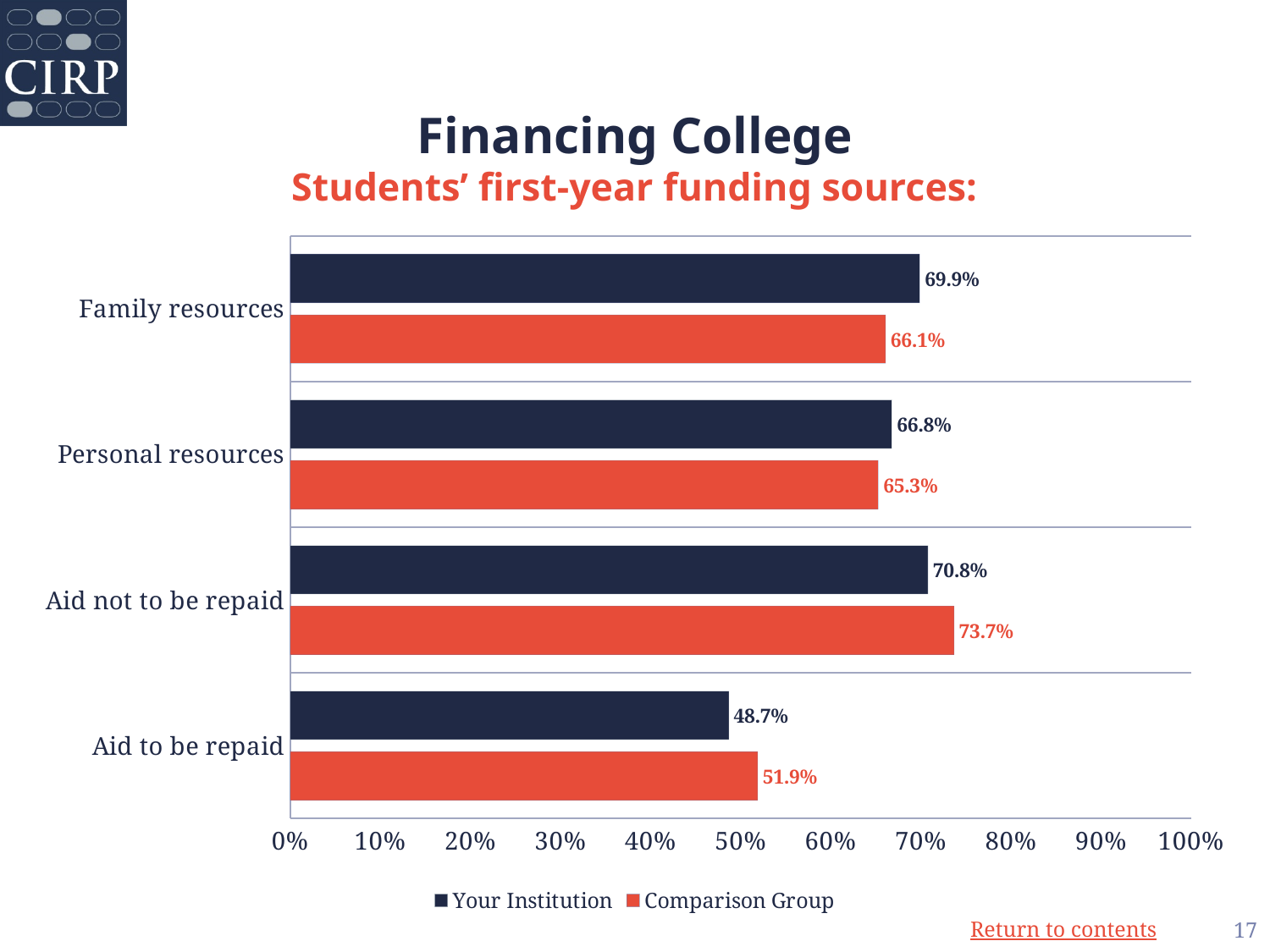
What is the value for Comparison Group for Aid not to be repaid? 73.7% What is the difference between Your Institution and Comparison Group for Family resources? 3.8% What is the value for Comparison Group for Aid to be repaid? 51.9% How many categories are shown on the chart? 4 What is the difference between Your Institution and Comparison Group for Aid to be repaid? 3.2% What kind of chart is shown on the slide? Bar chart How many series does the legend list? 2 Which category has the highest value for Your Institution? Aid not to be repaid Is the value for Your Institution for Aid to be repaid greater or less than 50%? less Which category has the lowest value for Comparison Group? Aid to be repaid What is the value for Your Institution for Family resources? 69.9% For Aid not to be repaid, which is larger: Your Institution or Comparison Group? Comparison Group